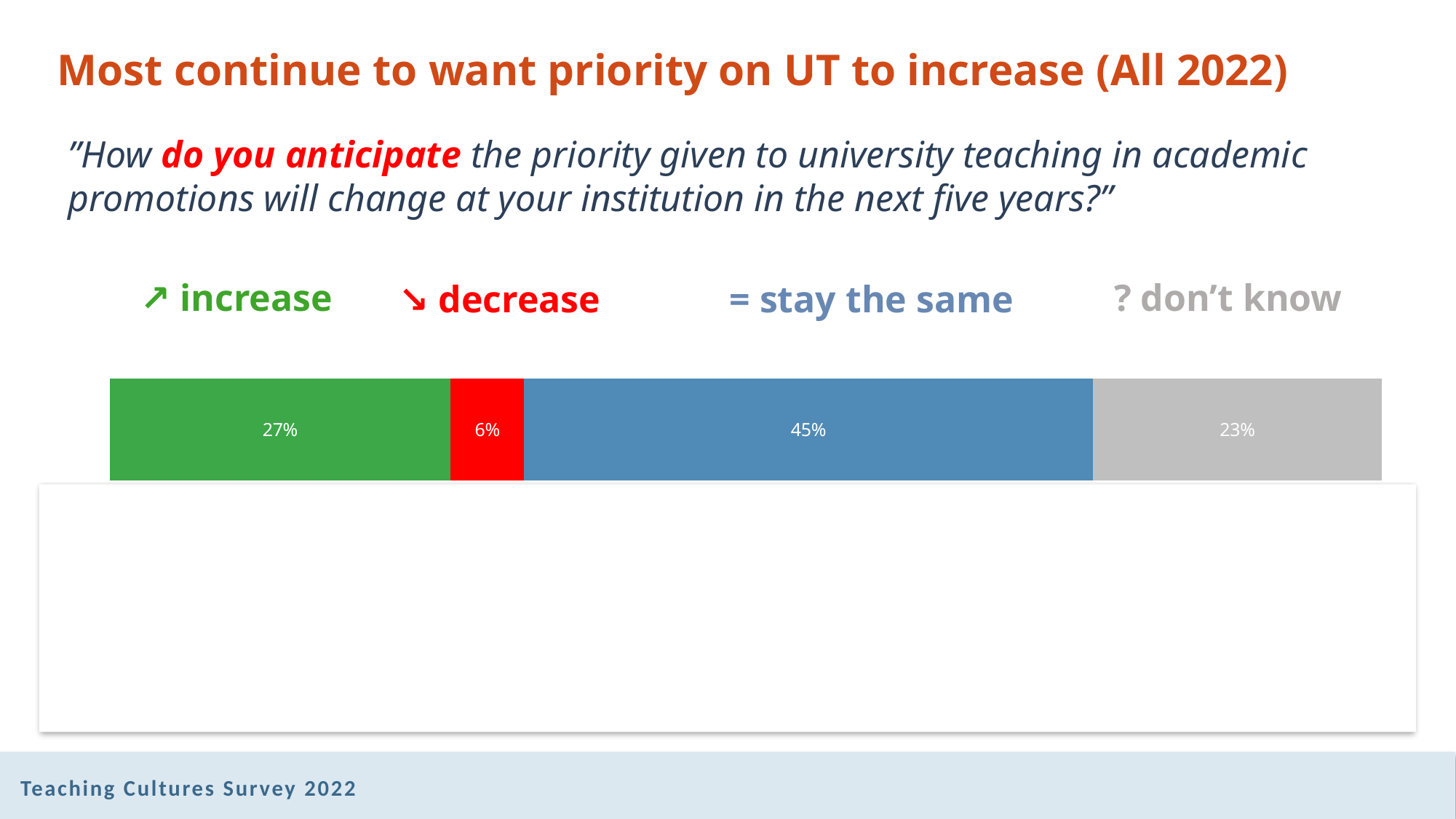
What percentage of respondents anticipate the priority given to university teaching will increase? 27% What is the difference in percentage points between 'increase' and 'decrease'? 21 What is the difference in percentage points between 'stay the same' and 'increase'? 18 Which is larger, the share for 'increase' or the share for 'don't know'? increase What percentage of respondents answered 'don't know'? 23% How many response categories are shown in the bar? 4 Which response category has the largest share? stay the same What colour is the segment representing 'decrease'? red Which response category has the smallest share? decrease What percentage of respondents anticipate the priority will decrease? 6% What percentage of respondents anticipate the priority will stay the same? 45% What kind of chart is shown on the slide? stacked bar chart